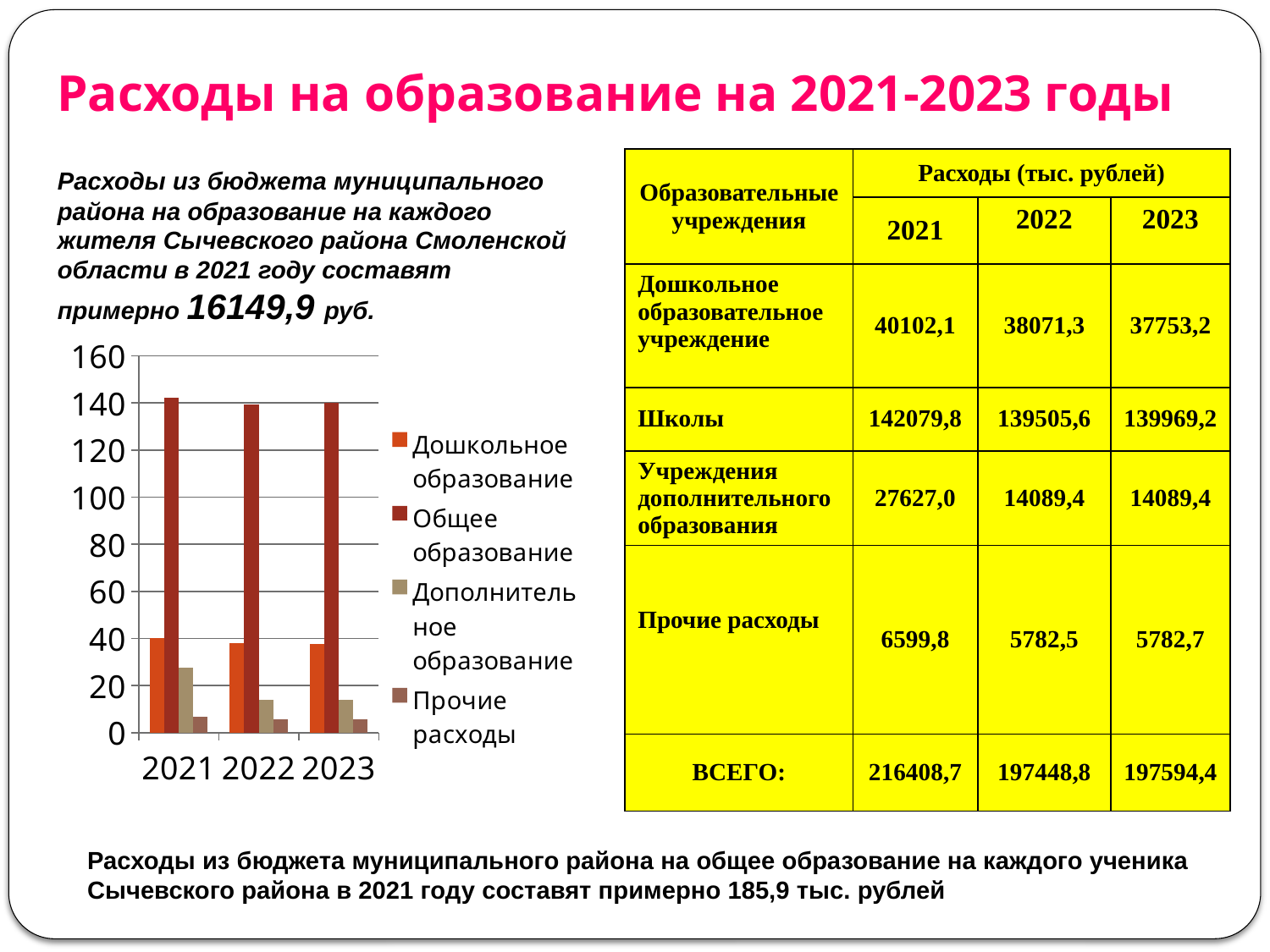
Is the value for Дополнительное образование in 2022 greater or less than 20? less Which series has the shortest bar in 2023? Прочие расходы How many series does the chart legend list? 4 Is the value for Дошкольное образование in 2023 greater or less than 20? greater What kind of chart is shown on the slide? bar chart What is the highest value shown on the chart's vertical axis? 160 Which is larger in 2022: Дошкольное образование or Дополнительное образование? Дошкольное образование How many years (categories) are shown on the x axis of the chart? 3 Does the value for Дополнительное образование rise or fall from 2021 to 2022? fall Is the value for Прочие расходы in 2021 greater or less than 20? less Which series has the tallest bar in 2021? Общее образование